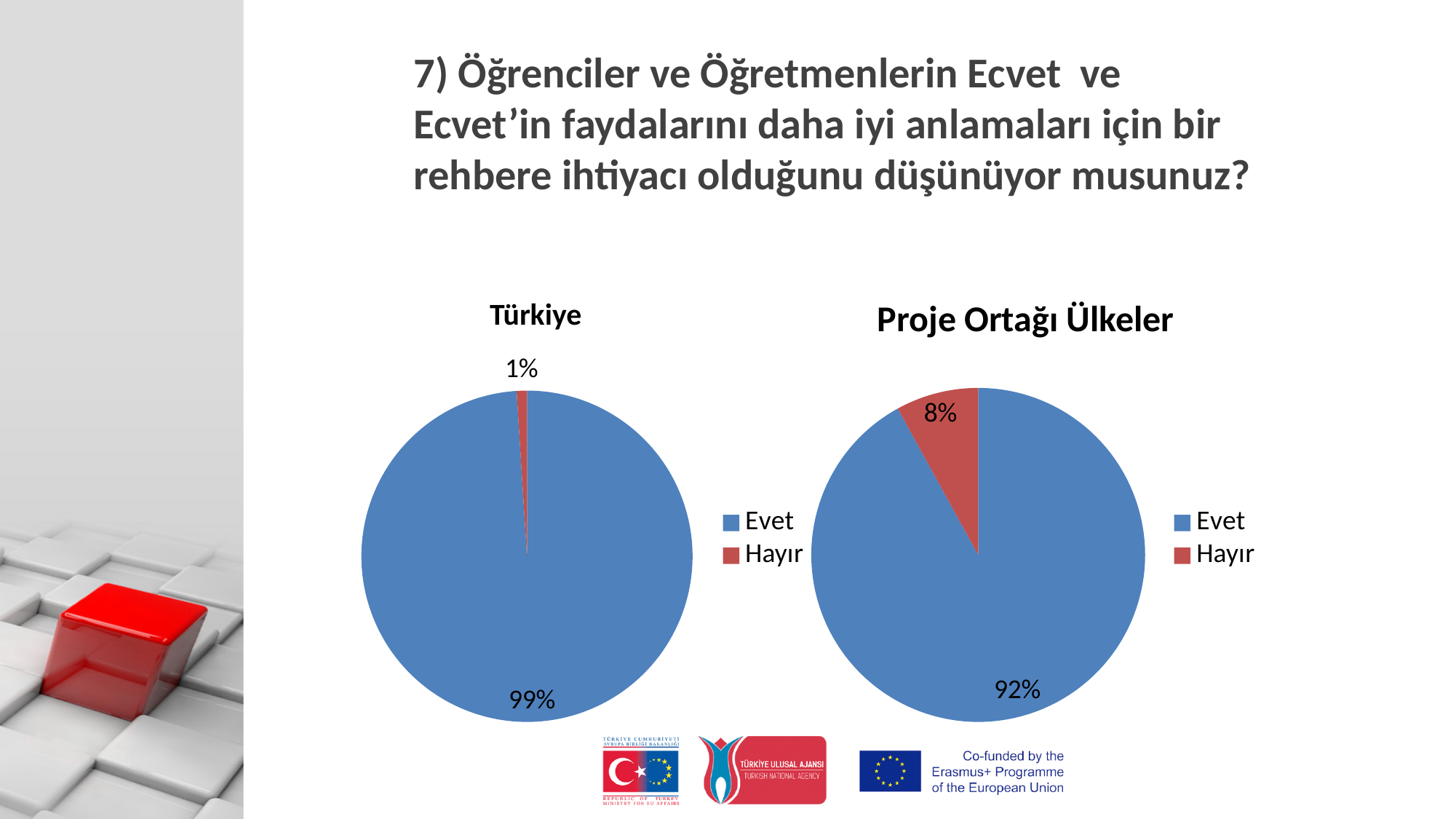
In the 'Proje Ortağı Ülkeler' pie chart, what colour is the Hayır slice? Red How many slices does the 'Proje Ortağı Ülkeler' pie chart have? 2 In the 'Türkiye' pie chart, which slice is the largest? Evet In the 'Proje Ortağı Ülkeler' pie chart, what percentage is shown for Evet? 92% In the 'Türkiye' pie chart, what percentage is shown for Evet? 99% How many entries does the legend of the 'Türkiye' chart list? 2 Which chart shows a larger Hayır share, 'Türkiye' or 'Proje Ortağı Ülkeler'? Proje Ortağı Ülkeler In the 'Proje Ortağı Ülkeler' pie chart, which slice is the smallest? Hayır In the 'Proje Ortağı Ülkeler' pie chart, what percentage is shown for Hayır? 8% In the 'Proje Ortağı Ülkeler' pie chart, what is the difference between the Evet and Hayır percentages? 84% What type of chart is the 'Türkiye' chart? Pie chart In the 'Türkiye' pie chart, what percentage is shown for Hayır? 1%